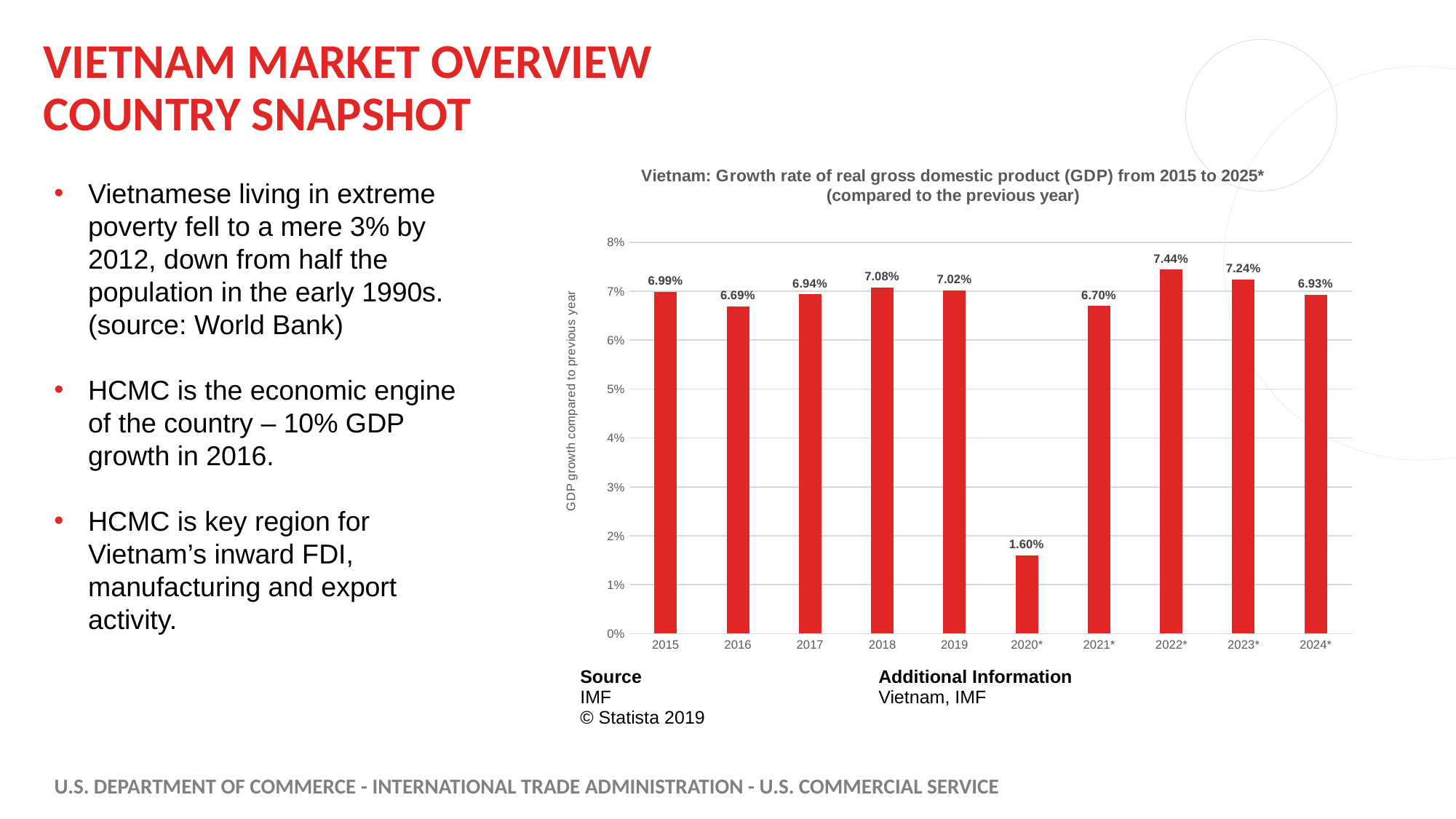
What is the GDP growth rate shown for 2018? 7.08% What kind of chart is shown on the slide? Bar chart What is the label on the vertical axis of the chart? GDP growth compared to previous year Which year has the highest GDP growth rate on the chart? 2022* Which is larger, the GDP growth rate for 2015 or for 2019? 2019 What is the GDP growth rate shown for 2016? 6.69% How many years are plotted on the chart? 10 Which year has the lowest GDP growth rate on the chart? 2020* What is the GDP growth rate shown for 2020*? 1.60% Does the GDP growth rate rise or fall from 2020* to 2022*? Rise Is the value for 2020* greater or less than 2%? less What is the difference between the GDP growth rates for 2022* and 2023*? 0.20%